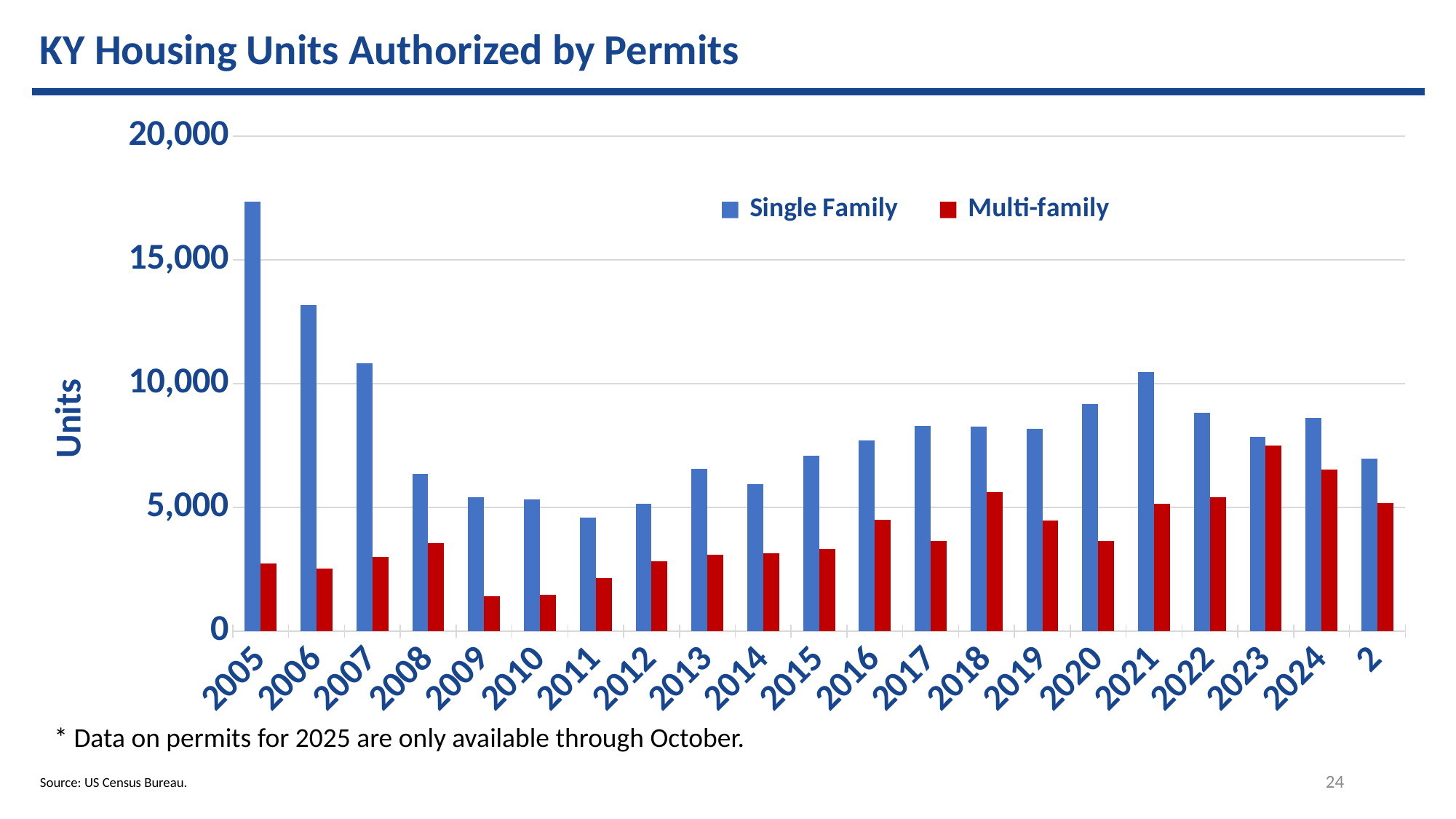
What kind of chart is shown on the slide? Bar chart In 2005, which is larger: Single Family or Multi-family? Single Family Is the Single Family value for 2006 greater or less than 10,000? greater Which year has the highest Single Family value? 2005 Which year has the highest Multi-family value? 2023 Which year has the lowest Single Family value? 2011 Which is larger: the Multi-family value for 2018 or for 2017? 2018 Is the Multi-family value for 2023 greater or less than 5,000? greater How many series does the legend list? 2 Is the Single Family value for 2005 greater or less than 15,000? greater Do the Single Family values rise or fall from 2005 to 2011? Fall